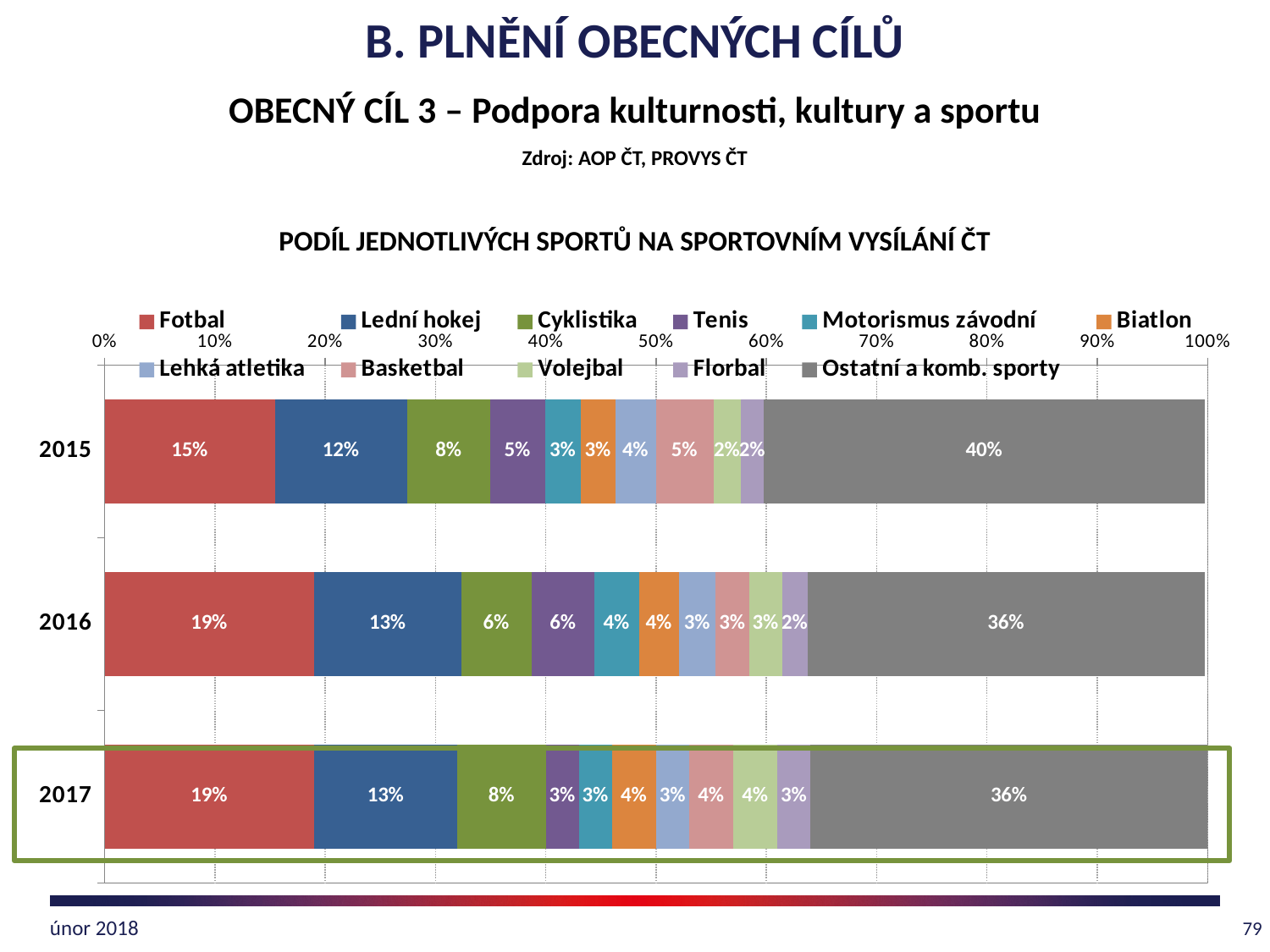
What share did Ostatní a komb. sporty have in 2017? 36% What share did Fotbal have in 2015? 15% What kind of chart is shown on the slide? Stacked bar chart What share did Tenis have in 2017? 3% Which sport had the largest share in 2015? Ostatní a komb. sporty Which year is highlighted with a green frame on the chart? 2017 By how many percentage points did the Fotbal share change from 2015 to 2016? 4 percentage points How many years are shown in the chart? 3 How many series does the legend list? 11 Which was larger in 2017, the share of Cyklistika or the share of Tenis? Cyklistika What share did Cyklistika have in 2016? 6% Which sport had the smallest share in 2016? Florbal